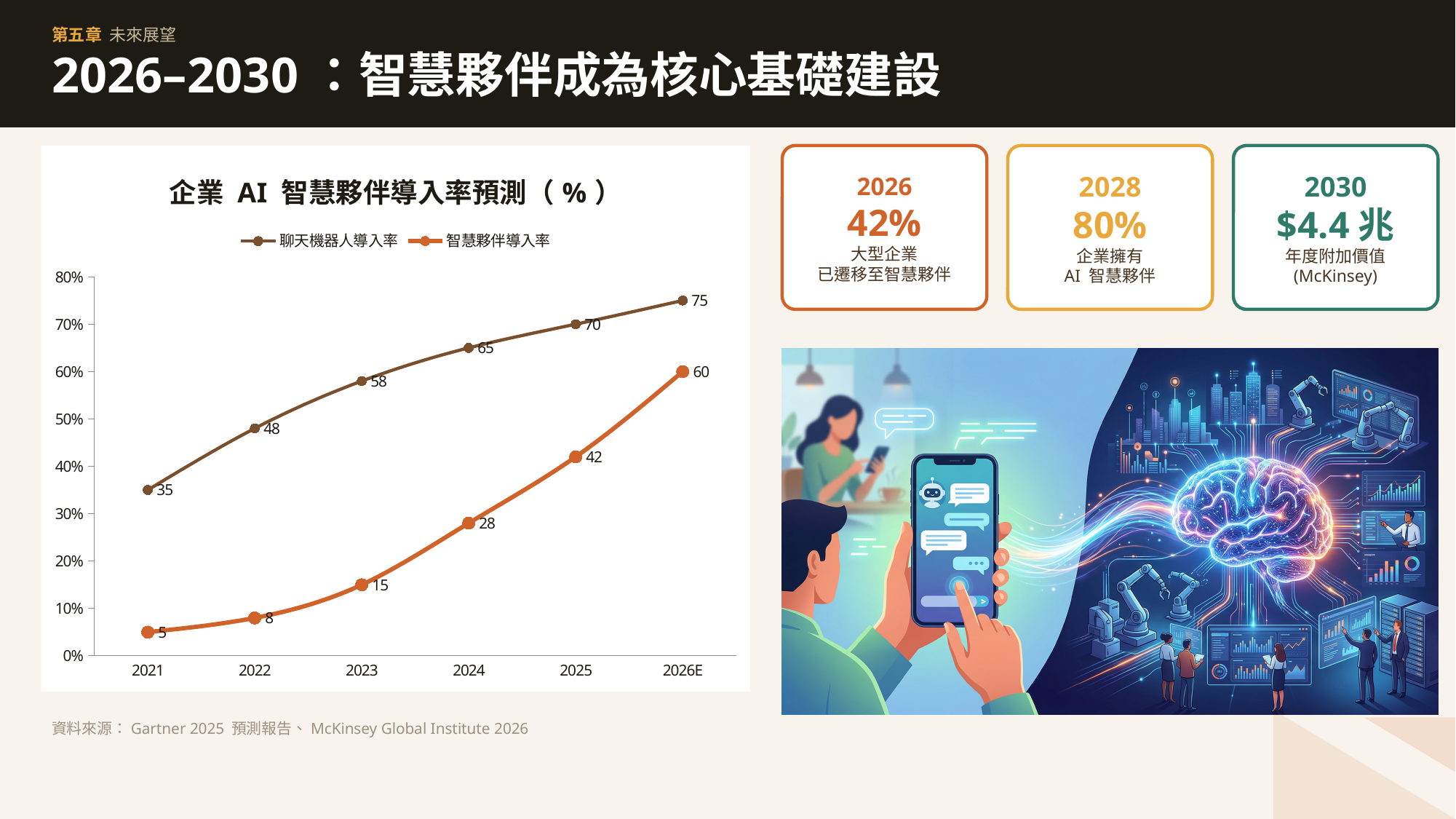
How many series does the legend list? 2 Does 智慧夥伴導入率 rise or fall from 2021 to 2026E? rise What kind of chart is shown? line chart Which series has the larger value in 2025, 聊天機器人導入率 or 智慧夥伴導入率? 聊天機器人導入率 In which year is 智慧夥伴導入率 lowest? 2021 What is the value for 智慧夥伴導入率 in 2024? 28 How many years are shown on the x axis? 6 Is the value for 智慧夥伴導入率 in 2023 greater or less than 20%? less What is the value for 聊天機器人導入率 in 2023? 58 What is the value for 智慧夥伴導入率 in 2026E? 60 What is the difference between 聊天機器人導入率 and 智慧夥伴導入率 in 2021? 30 In which year is 聊天機器人導入率 highest? 2026E